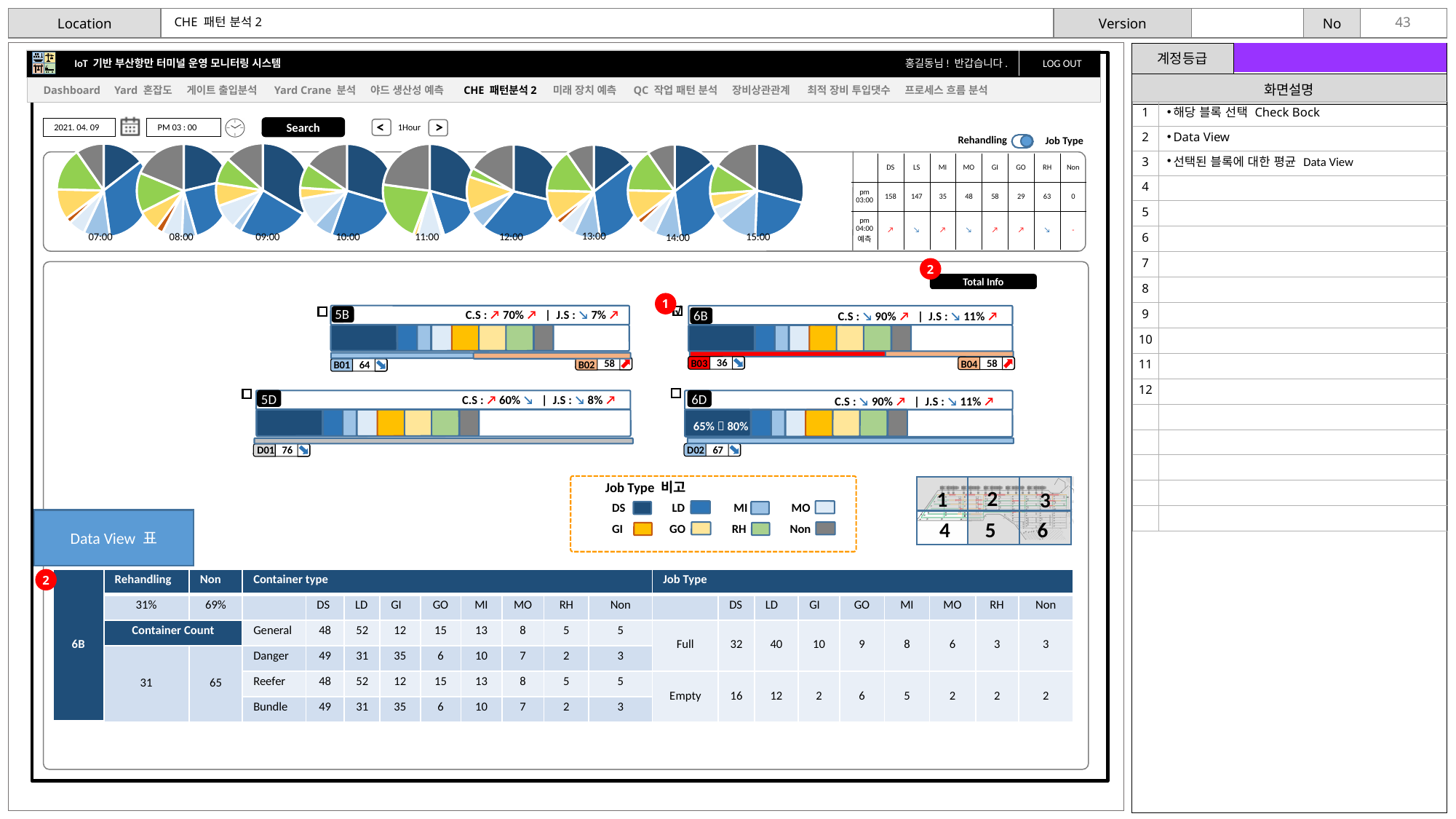
How many job types does the 'Job Type 비고' legend list? 8 What is the difference between the D01 value under the 5D bar and the D02 value under the 6D bar? 9 Among B01, B02, B03 and B04 shown under the 5B and 6B bars, which has the lowest value? B03 What kind of charts are shown in the row labelled 07:00 through 15:00 at the top of the dashboard? Pie charts In the stacked bar for block 5B, what C.S value is shown? 70% In the stacked bar for block 6B, what J.S value is shown? 11% Under the 5B bar, which is larger, the value for B01 or the value for B02? B01 Below the block 6B bar, what value is shown for B03? 36 In the 'Job Type 비고' legend, which job type is shown in green? RH How many pie charts are shown in the hourly row at the top of the dashboard? 9 In the stacked bar for block 5D, what C.S value is shown? 60% In the 'Job Type 비고' legend, which job type is shown in grey? Non